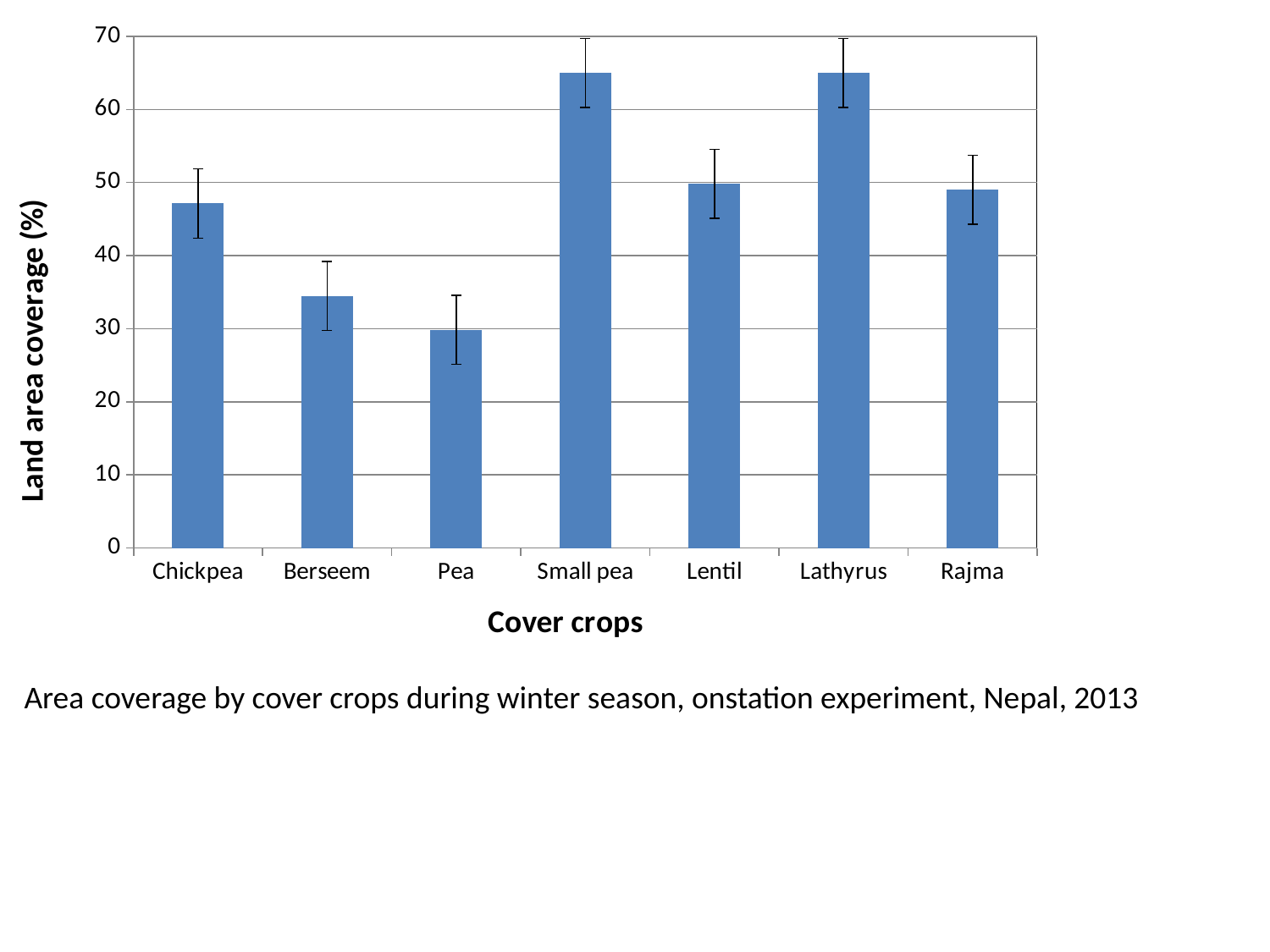
What is the title of the vertical axis? Land area coverage (%) Which has the higher land area coverage, Chickpea or Berseem? Chickpea What kind of chart is shown on the slide? bar chart Is the land area coverage for Berseem greater or less than 40? less Is the land area coverage for Chickpea greater or less than 40? greater Is the land area coverage for Pea greater or less than 20? greater Which cover crop has the lowest land area coverage? Pea How many cover crops are shown on the x axis? 7 Which has the higher land area coverage, Small pea or Lentil? Small pea